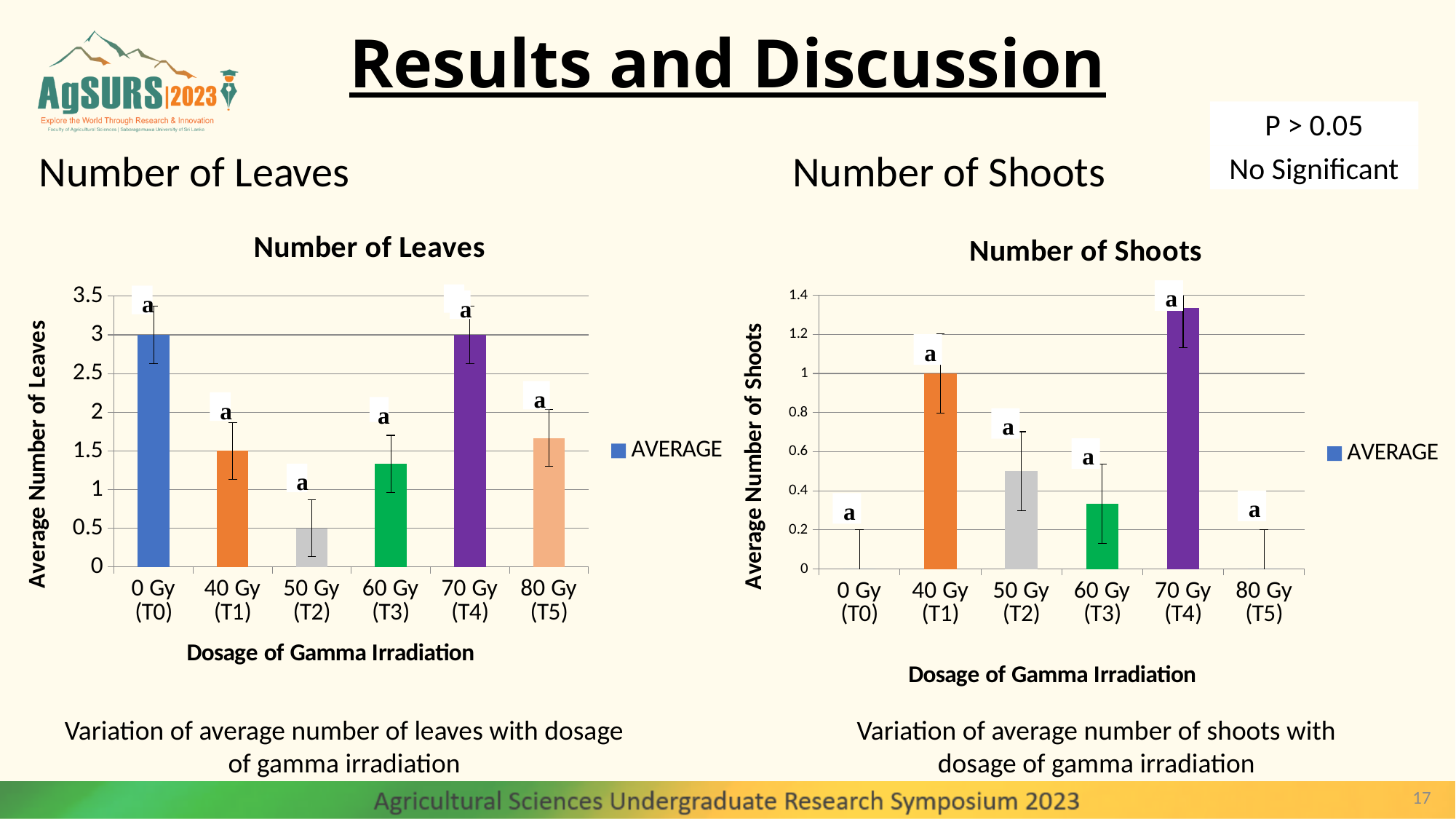
In the Number of Leaves chart, is the value for 80 Gy (T5) greater or less than 2? less In the Number of Leaves chart, is the value for 60 Gy (T3) greater or less than 1? greater What kind of chart is the Number of Leaves chart? bar chart In the Number of Shoots chart, which is larger, the value for 40 Gy (T1) or 50 Gy (T2)? 40 Gy (T1) In the Number of Shoots chart, is the value for 60 Gy (T3) greater or less than 0.4? less In the Number of Shoots chart, what is the average number of shoots for 40 Gy (T1)? 1 In the Number of Leaves chart, which dosage has the lowest average number of leaves? 50 Gy (T2) In the Number of Leaves chart, what is the average number of leaves for 0 Gy (T0)? 3 In the Number of Leaves chart, what is the difference between the values for 0 Gy (T0) and 40 Gy (T1)? 1.5 In the Number of Leaves chart, what is the average number of leaves for 40 Gy (T1)? 1.5 How many dosage categories are shown on the x axis of the Number of Shoots chart? 6 In the Number of Shoots chart, which dosage has the highest average number of shoots? 70 Gy (T4)